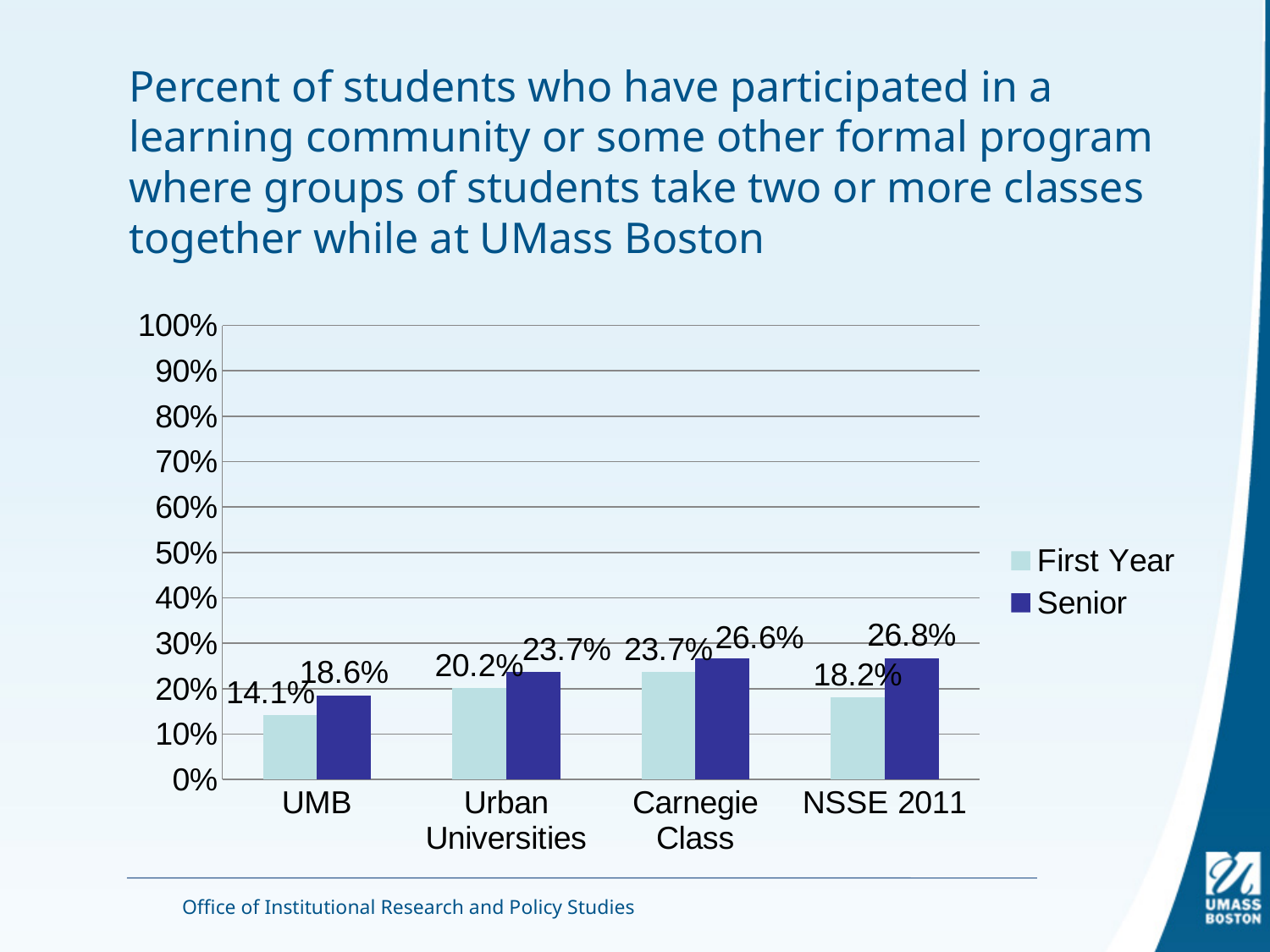
What is the First Year value for UMB? 14.1% What is the Senior value for NSSE 2011? 26.8% What is the First Year value for Carnegie Class? 23.7% Which category has the highest First Year value? Carnegie Class How many categories are shown on the x axis? 4 Which is larger, the First Year value for Urban Universities or the First Year value for NSSE 2011? Urban Universities What is the Senior value for Urban Universities? 23.7% What kind of chart is shown on the slide? Bar chart How many series does the legend list? 2 What is the difference between the Senior and First Year values for NSSE 2011? 8.6% Which category has the lowest Senior value? UMB What is the difference between the Senior and First Year values for UMB? 4.5%